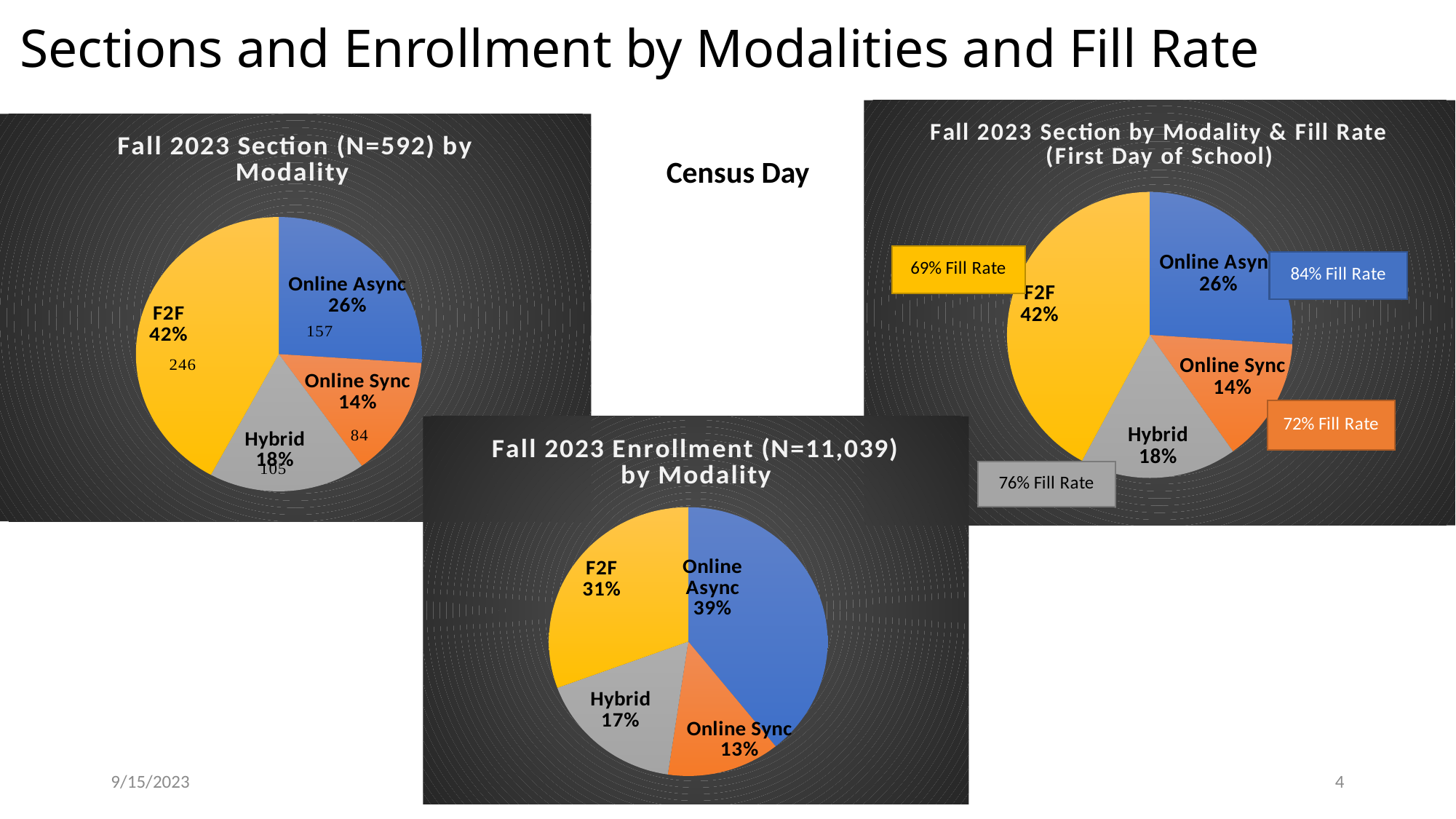
In the 'Fall 2023 Section (N=592) by Modality' chart, which modality has the smallest slice? Online Sync What type of chart is used for 'Fall 2023 Section (N=592) by Modality'? Pie chart In the 'Fall 2023 Section by Modality & Fill Rate (First Day of School)' chart, what is the fill rate for Online Async? 84% Fill Rate In the 'Fall 2023 Enrollment (N=11,039) by Modality' chart, what share of enrollment is Online Async? 39% In the 'Fall 2023 Section (N=592) by Modality' chart, what is the difference between the number of F2F sections and Hybrid sections? 141 How many modality categories does the 'Fall 2023 Enrollment (N=11,039) by Modality' chart show? 4 In the 'Fall 2023 Section (N=592) by Modality' chart, what share of sections is F2F? 42% In the 'Fall 2023 Enrollment (N=11,039) by Modality' chart, which is larger, the Hybrid share or the Online Sync share? Hybrid In the 'Fall 2023 Section (N=592) by Modality' chart, how many sections are Online Async? 157 In the 'Fall 2023 Enrollment (N=11,039) by Modality' chart, which modality has the largest share? Online Async In the 'Fall 2023 Section by Modality & Fill Rate (First Day of School)' chart, which modality has the lowest fill rate? F2F In the 'Fall 2023 Section by Modality & Fill Rate (First Day of School)' chart, what is the difference between the Hybrid fill rate and the Online Sync fill rate? 4%